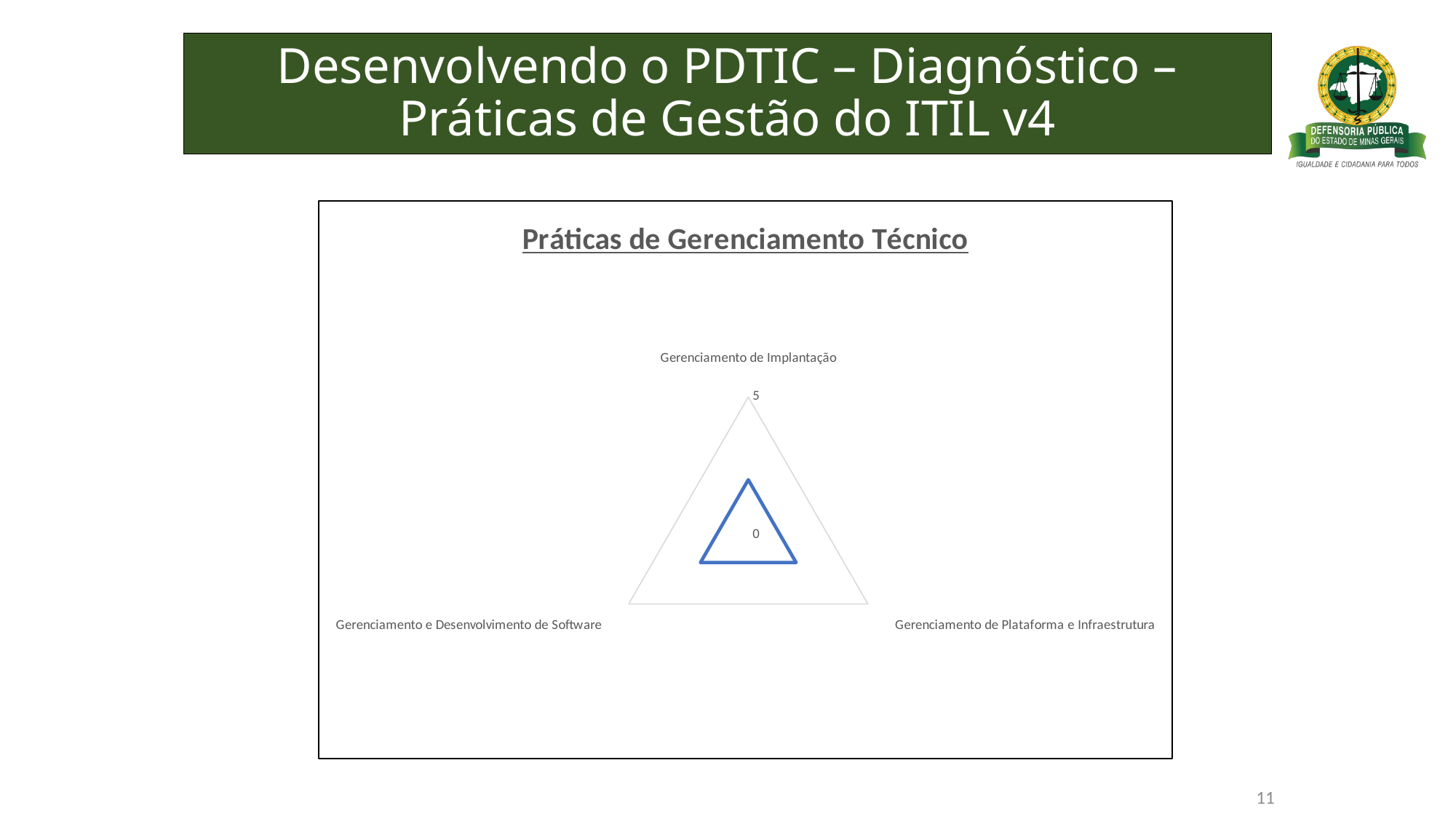
What is the title of the chart? Práticas de Gerenciamento Técnico Which category is labelled at the top of the radar chart? Gerenciamento de Implantação Is the value for Gerenciamento e Desenvolvimento de Software greater or less than 5? less Is the value for Gerenciamento de Plataforma e Infraestrutura greater or less than 5? less What is the maximum value shown on the radar chart's axis? 5 How many categories (axes) does the radar chart have? 3 Is the value for Gerenciamento de Implantação greater or less than 0? greater What kind of chart is shown on the slide? Radar chart